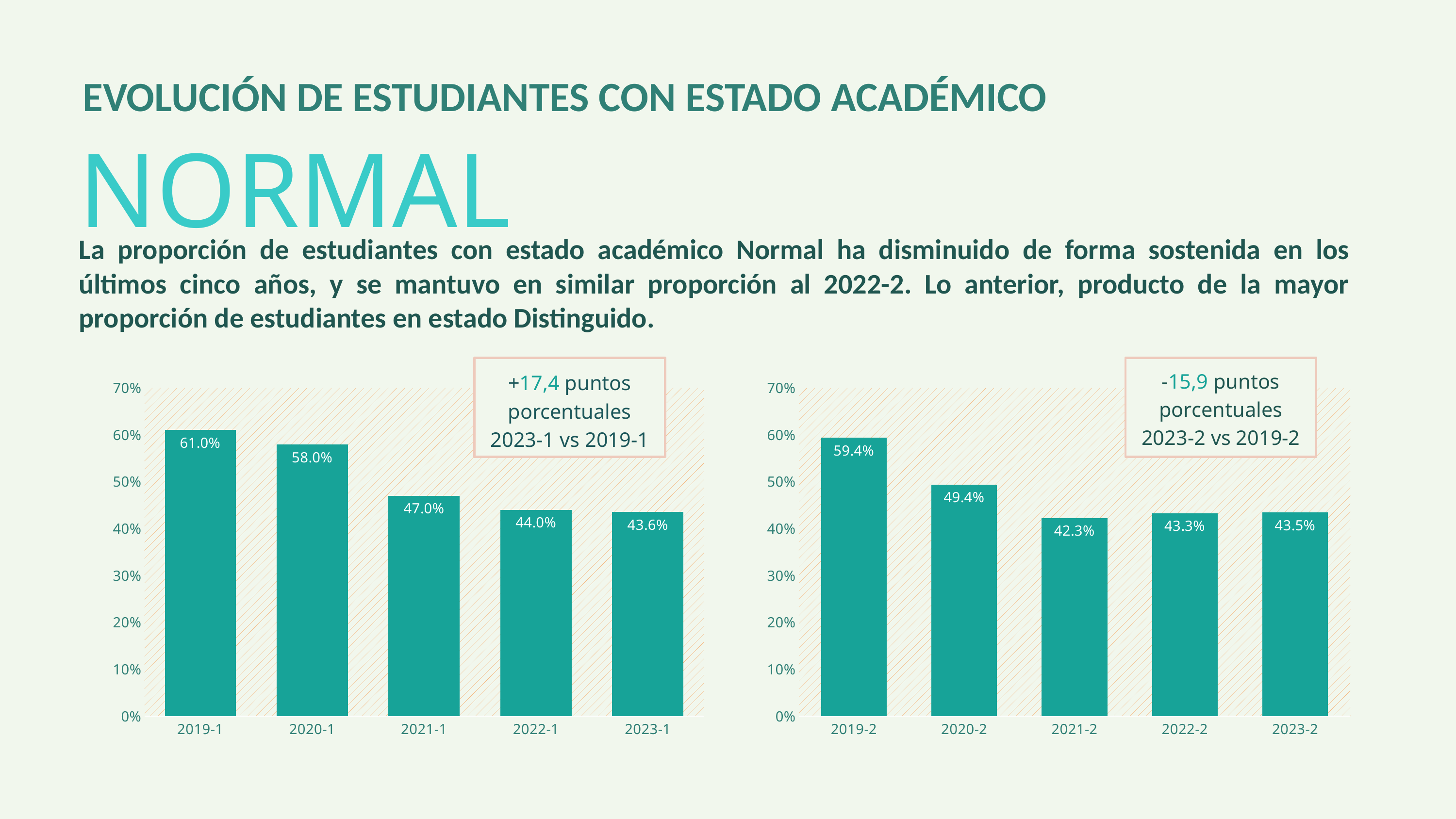
In the left chart, what is the value for 2019-1? 61.0% What does the annotation box above the right chart say? -15,9 puntos porcentuales 2023-2 vs 2019-2 How many periods are shown on the x axis of the left chart? 5 In the left chart, what is the difference between the values for 2019-1 and 2023-1? 17.4 percentage points In the left chart, which period has the lowest value? 2023-1 In the right chart, is the value for 2020-2 greater or less than 40%? greater In the left chart, do the values rise or fall from 2019-1 to 2023-1? fall In the right chart, which period has the highest value? 2019-2 What type of chart is the right chart? bar chart In the right chart, what is the value for 2021-2? 42.3% In the left chart, which is larger, the value for 2020-1 or the value for 2021-1? 2020-1 In the right chart, what is the difference between the values for 2019-2 and 2020-2? 10.0 percentage points